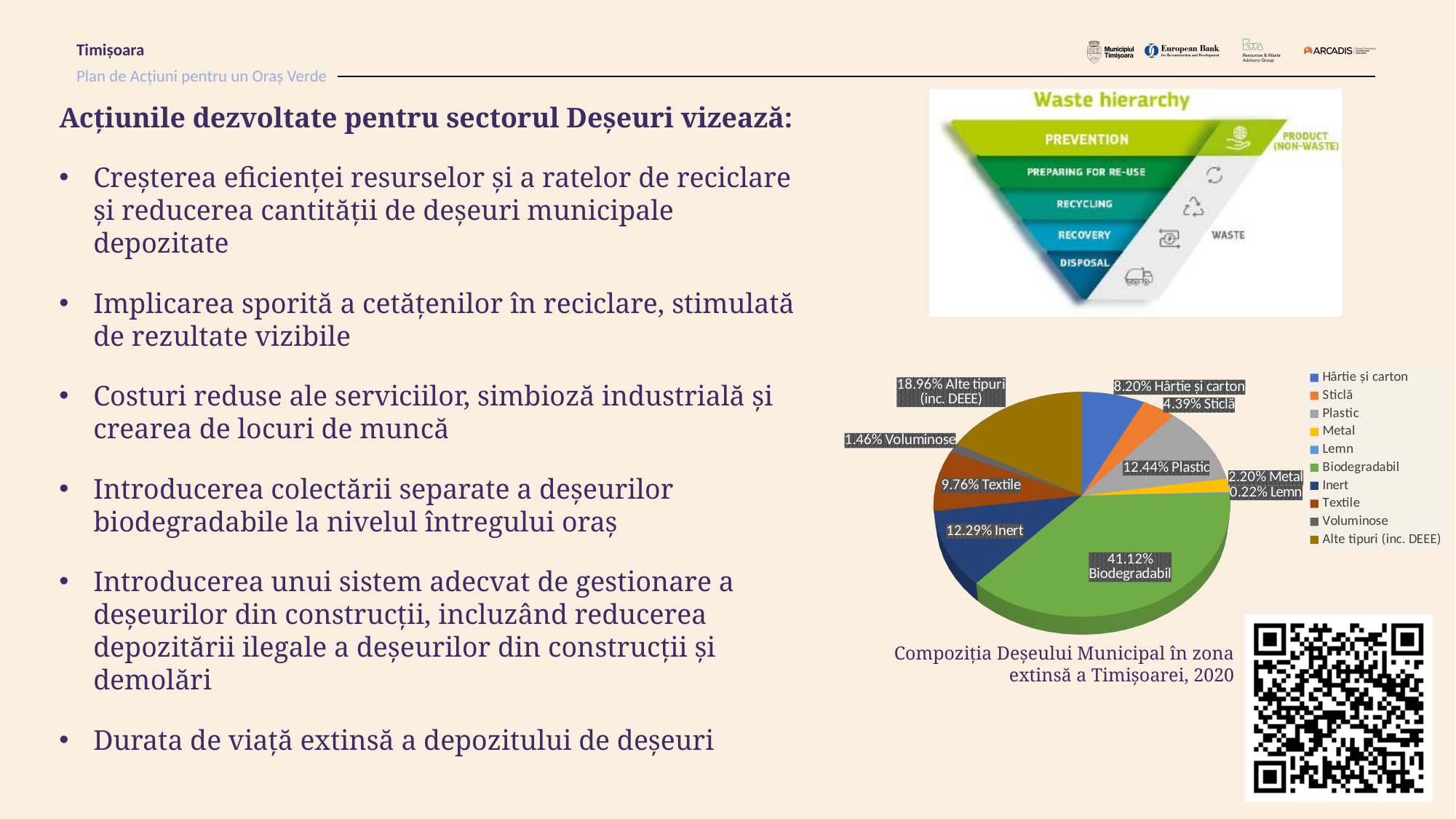
Which is larger in the pie chart: Textile or Hârtie și carton? Textile What share of the pie chart does Biodegradabil represent? 41.12% How many categories does the pie chart legend list? 10 What is the difference between the shares of Plastic and Inert in the pie chart? 0.15% What is the value shown for Plastic in the pie chart? 12.44% What is the value shown for Voluminose in the pie chart? 1.46% What is the combined share of Metal and Lemn in the pie chart? 2.42% Which category has the largest share in the pie chart? Biodegradabil What is the value shown for Alte tipuri (inc. DEEE) in the pie chart? 18.96% What caption is given below the pie chart? Compoziția Deșeului Municipal în zona extinsă a Timișoarei, 2020 Which category has the smallest share in the pie chart? Lemn What type of chart is shown on the slide? Pie chart